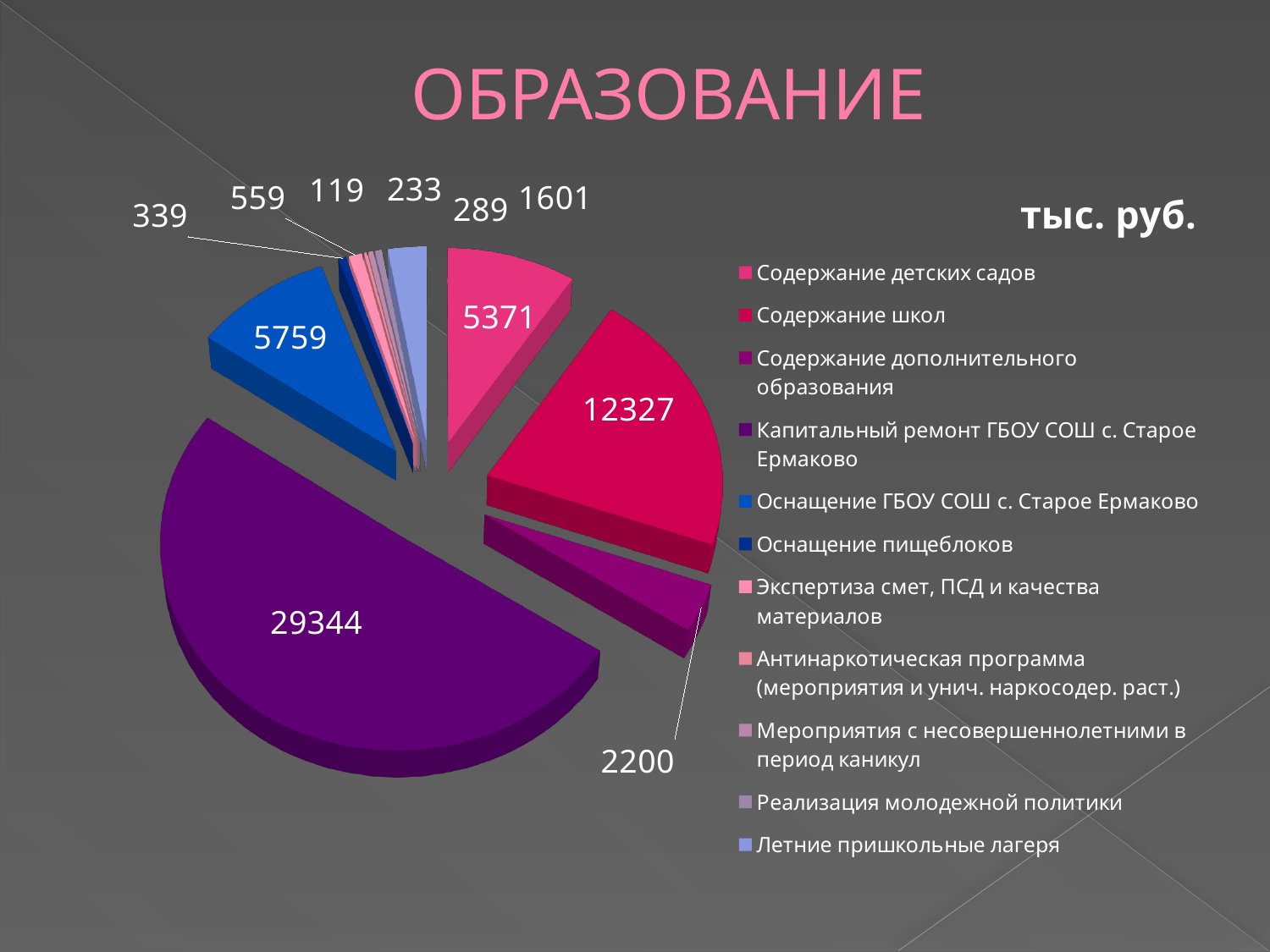
What kind of chart is shown on the slide? pie chart What is the title of the chart on the slide? тыс. руб. What is the value for Содержание дополнительного образования? 2200 What is the difference between the values for Содержание школ and Содержание детских садов? 6956 How many categories does the legend of the pie chart list? 11 In what units are the values on the chart given? тыс. руб. Which is larger, the value for Оснащение ГБОУ СОШ с. Старое Ермаково or the value for Содержание детских садов? Оснащение ГБОУ СОШ с. Старое Ермаково What is the value for Содержание детских садов? 5371 What is the value for Оснащение ГБОУ СОШ с. Старое Ермаково? 5759 What is the value for Содержание школ? 12327 Which category has the largest slice of the pie? Капитальный ремонт ГБОУ СОШ с. Старое Ермаково What is the value for Капитальный ремонт ГБОУ СОШ с. Старое Ермаково? 29344